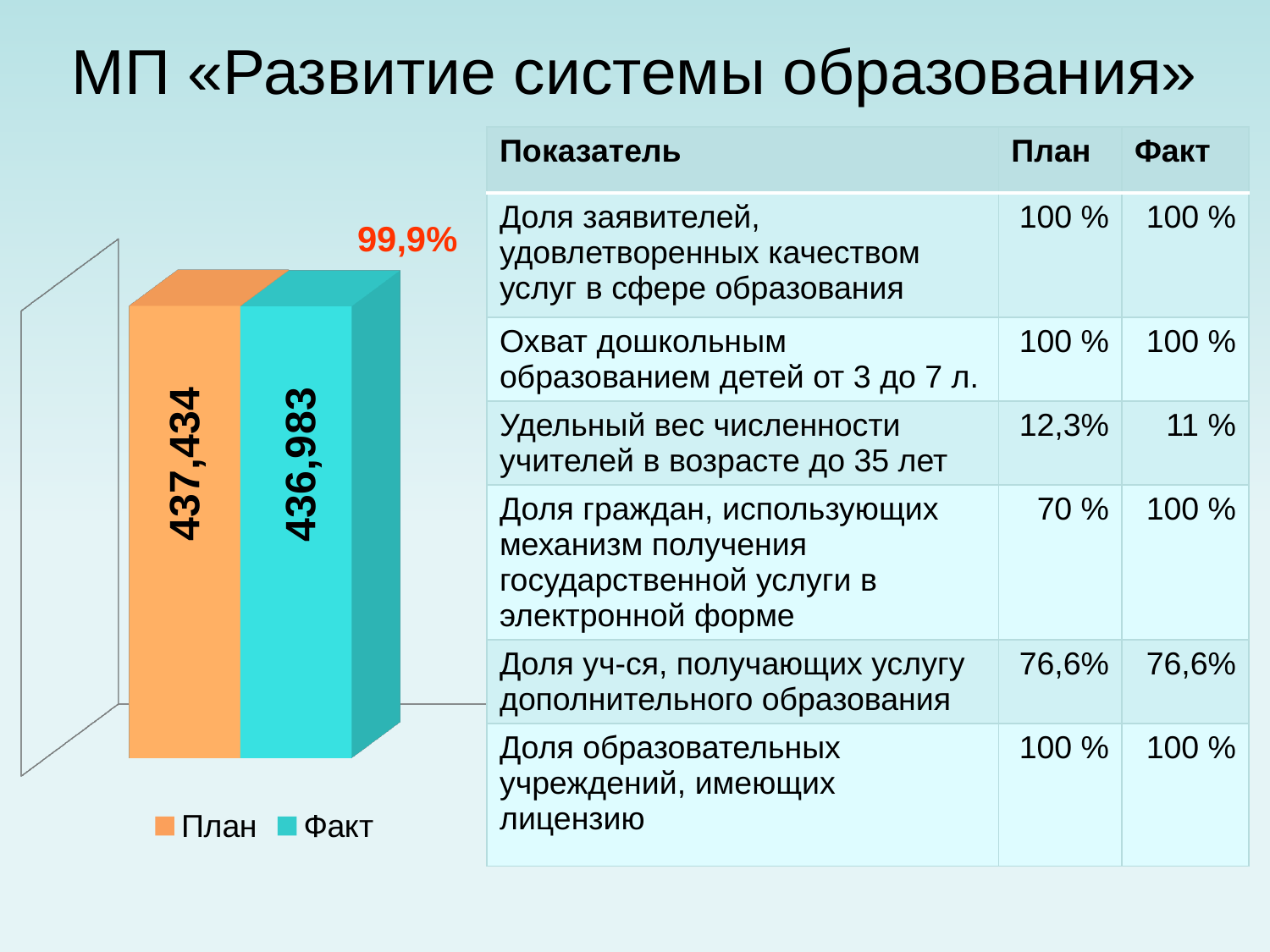
What is the value of the Факт bar in the chart? 436,983 Which bar in the chart is the lowest? Факт What percentage is printed in red above the bars in the chart? 99,9% How many bars are plotted in the chart? 2 What is the difference between the План and Факт values in the chart? 0,451 Which series has the higher value in the chart, План or Факт? План What colour is the Факт series in the chart legend? turquoise What is the value of the План bar in the chart? 437,434 How many series does the chart legend list? 2 Which bar in the chart is the highest? План What kind of chart is shown on the slide? bar chart